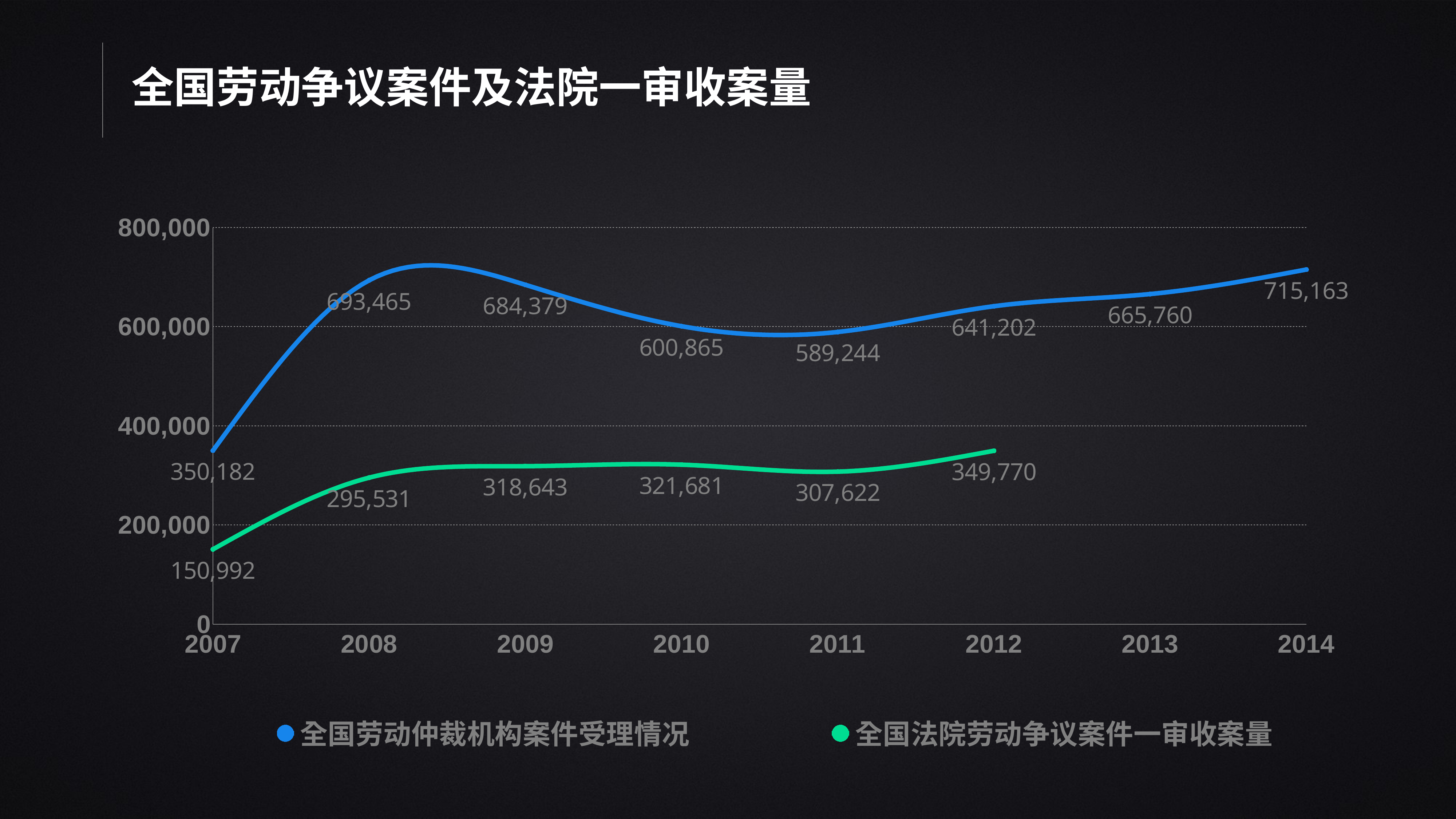
What type of chart is shown on the slide? line chart How many series does the legend list? 2 What is the value for 全国劳动仲裁机构案件受理情况 in 2011? 589,244 In which year is 全国法院劳动争议案件一审收案量 lowest? 2007 What is the difference between the 2008 and 2007 values for 全国劳动仲裁机构案件受理情况? 343,283 What is the value for 全国法院劳动争议案件一审收案量 in 2007? 150,992 How many years are shown on the x axis? 8 Does 全国劳动仲裁机构案件受理情况 rise or fall from 2011 to 2014? rise In which year is 全国劳动仲裁机构案件受理情况 highest? 2014 What is the title of the chart? 全国劳动争议案件及法院一审收案量 What is the value for 全国劳动仲裁机构案件受理情况 in 2014? 715,163 Which is larger for 全国法院劳动争议案件一审收案量: the 2010 value or the 2011 value? 2010